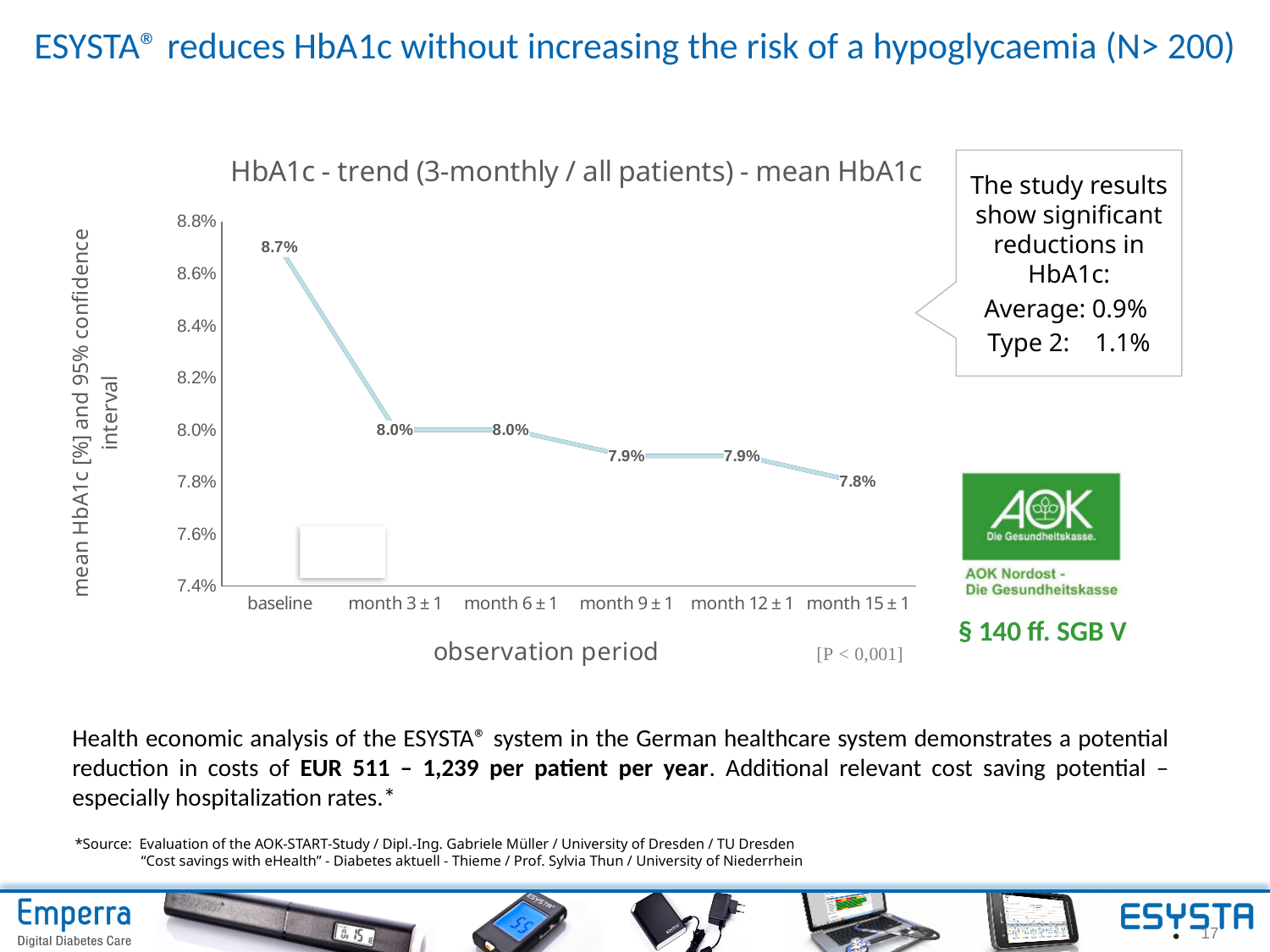
What is the title of the chart? HbA1c - trend (3-monthly / all patients) - mean HbA1c Which is larger, the mean HbA1c at baseline or at month 6 ± 1? baseline Which observation period has the lowest mean HbA1c value? month 15 ± 1 What is the mean HbA1c value at month 9 ± 1? 7.9% What is the difference between the mean HbA1c at baseline and at month 15 ± 1? 0.9% Which observation period has the highest mean HbA1c value? baseline What is the mean HbA1c value at month 3 ± 1? 8.0% Do the mean HbA1c values rise or fall from baseline to month 15 ± 1? fall What kind of chart is shown on the slide? line chart How many observation periods are plotted on the chart? 6 What is the mean HbA1c value at baseline? 8.7% What is the mean HbA1c value at month 15 ± 1? 7.8%